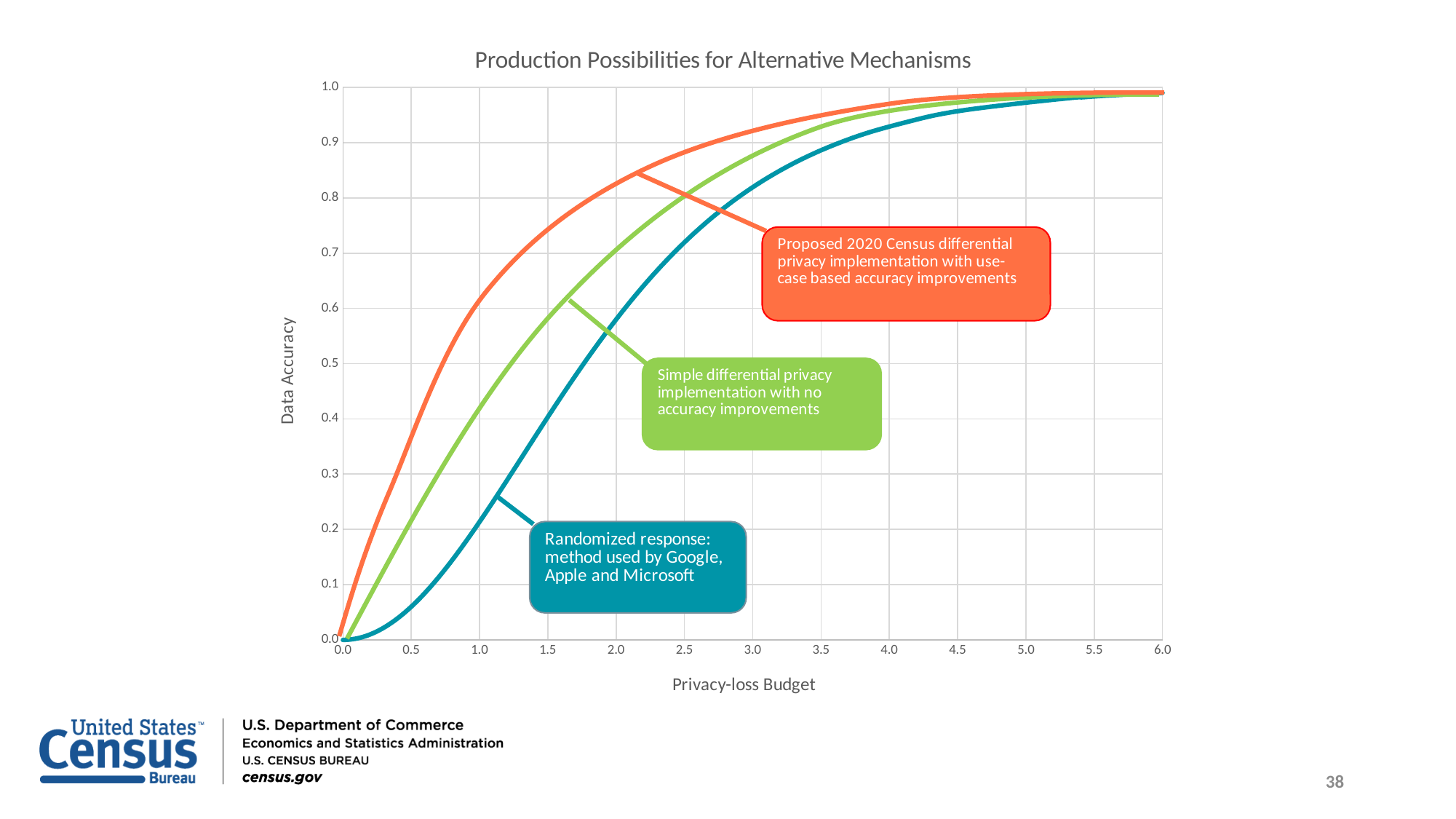
What is the title of the chart? Production Possibilities for Alternative Mechanisms At a privacy-loss budget of 2.0, is the data accuracy of the Randomized response curve greater or less than 0.5? greater At a privacy-loss budget of 1.0, is the data accuracy of the Simple differential privacy implementation curve greater or less than 0.5? less What is the label of the x axis of the chart? Privacy-loss Budget How many curves (series) are plotted on the chart? 3 Do the curves rise or fall as the privacy-loss budget increases along the x axis? Rise At a privacy-loss budget of 1.0, is the data accuracy of the Proposed 2020 Census differential privacy curve greater or less than 0.5? greater Which curve has the highest data accuracy at a privacy-loss budget of 1.5? Proposed 2020 Census differential privacy implementation with use-case based accuracy improvements At a privacy-loss budget of 1.0, which has higher data accuracy: the Proposed 2020 Census differential privacy curve or the Randomized response curve? Proposed 2020 Census differential privacy curve Which curve has the lowest data accuracy at a privacy-loss budget of 1.0? Randomized response: method used by Google, Apple and Microsoft What kind of chart is shown on the slide? Line chart